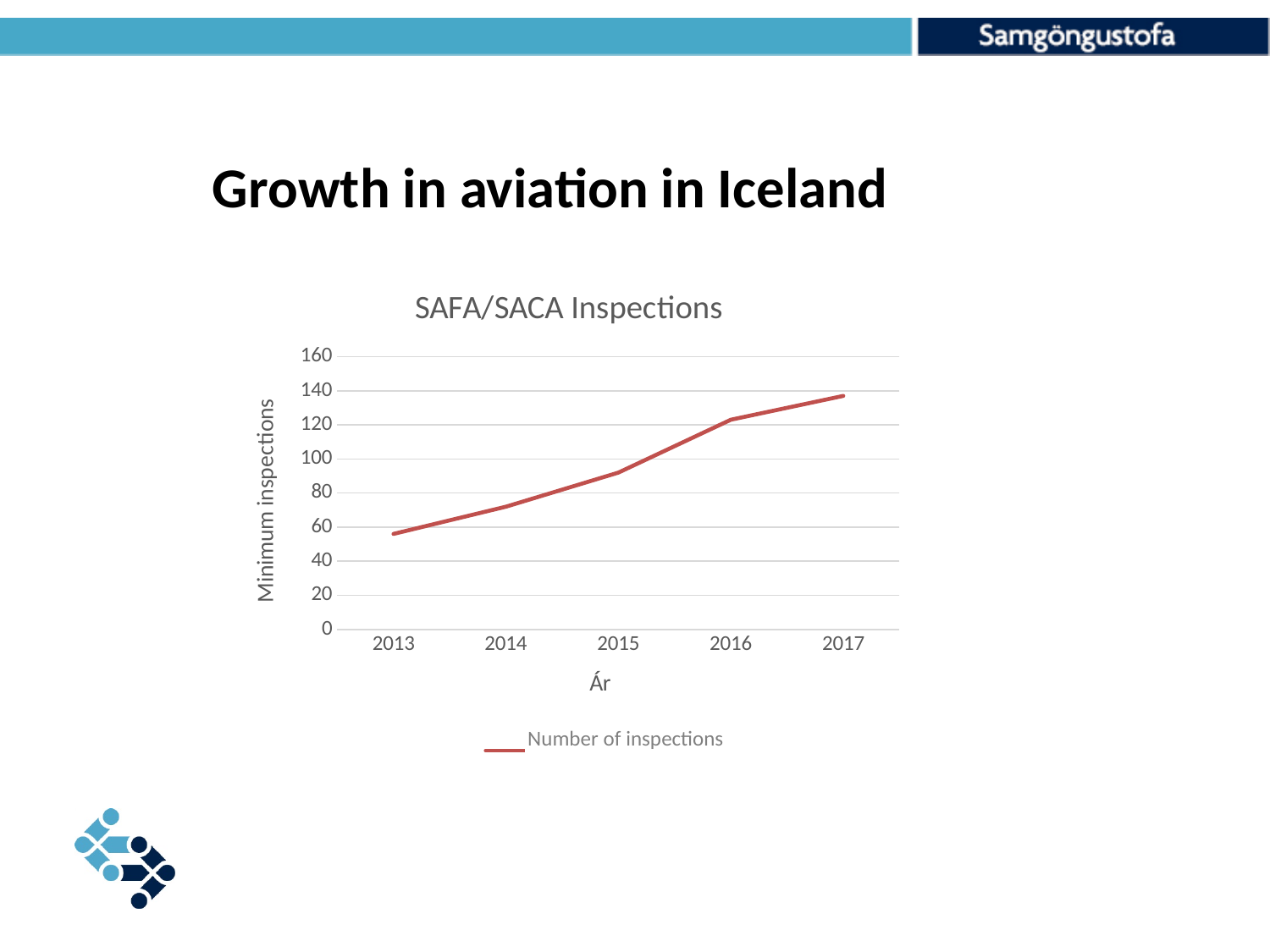
What is the title of the chart? SAFA/SACA Inspections Is the value for 2016 greater or less than 100? greater Which year has more inspections, 2014 or 2016? 2016 Which year has the highest number of inspections? 2017 Is the value for 2015 greater or less than 100? less Do the values rise or fall from 2013 to 2017? rise How many years are plotted on the x axis? 5 Is the value for 2013 greater or less than 80? less What kind of chart is shown on the slide? line chart Which year has the lowest number of inspections? 2013 How many series does the legend list? 1